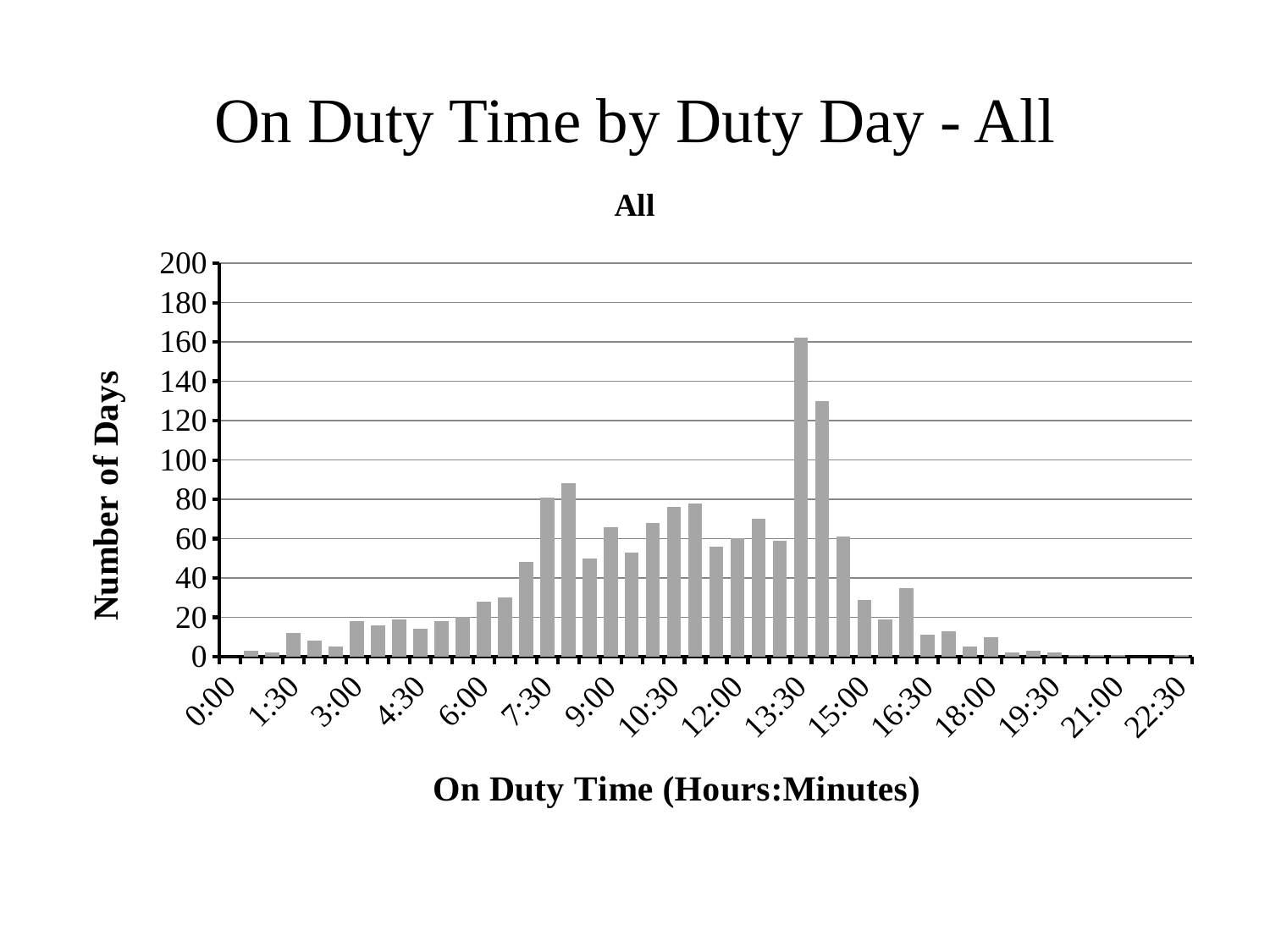
What is the title of the y axis? Number of Days Is the number of days for 10:30 greater or less than 60? greater Is the number of days for 7:30 greater or less than 60? greater Is the number of days for 15:00 greater or less than 40? less What kind of chart is shown on the slide? bar chart What is the title of the x axis? On Duty Time (Hours:Minutes) Which on duty time has the highest number of days? 13:30 Which has more days, 7:30 or 6:00? 7:30 Which has more days, 13:30 or 15:00? 13:30